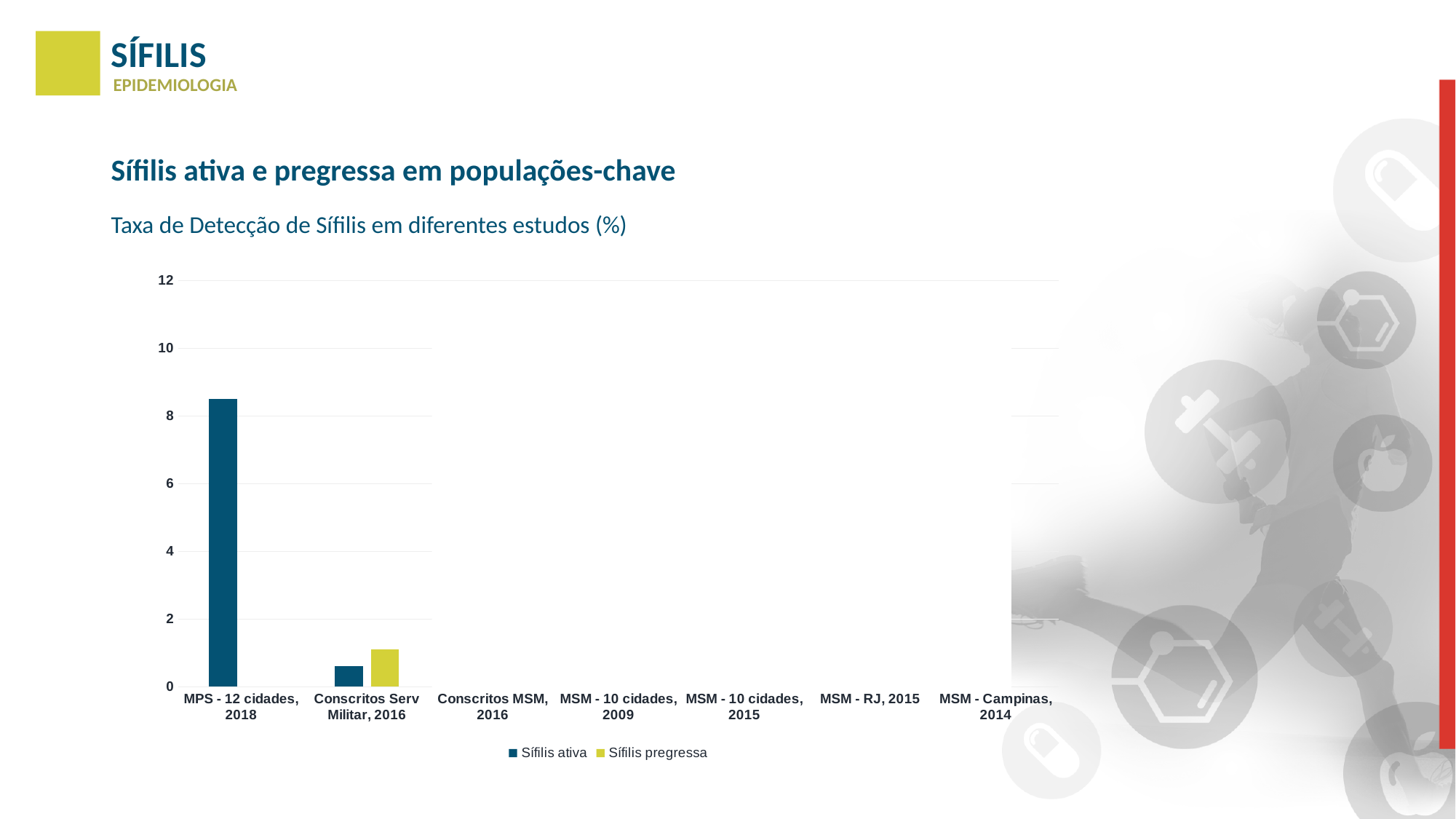
How many series does the chart legend list? 2 Which category has the tallest bar in the chart? MPS - 12 cidades, 2018 What is the title of the chart? Taxa de Detecção de Sífilis em diferentes estudos (%) What kind of chart is shown on the slide? bar chart Is the Sífilis ativa value for MPS - 12 cidades, 2018 greater or less than 8? greater Which has the larger Sífilis ativa value: MPS - 12 cidades, 2018 or Conscritos Serv Militar, 2016? MPS - 12 cidades, 2018 Is the Sífilis ativa value for MPS - 12 cidades, 2018 greater or less than 10? less What are the two series named in the chart legend? Sífilis ativa and Sífilis pregressa Is the Sífilis pregressa value for Conscritos Serv Militar, 2016 greater or less than 2? less How many categories are shown along the x axis of the chart? 7 For Conscritos Serv Militar, 2016, which series has the larger value: Sífilis ativa or Sífilis pregressa? Sífilis pregressa